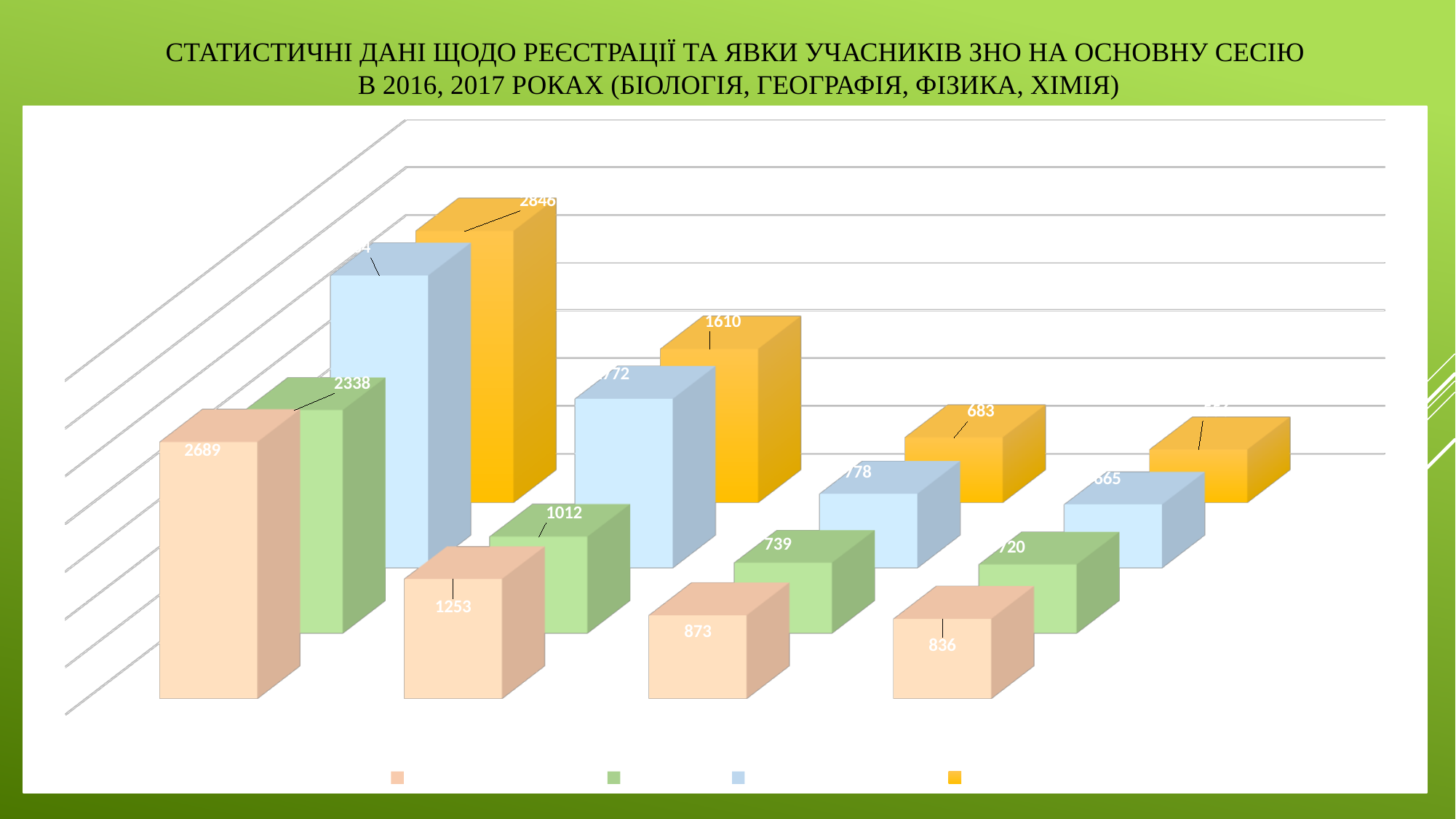
What is the difference between the peach bar values in the first and second groups from the left (2689 and 1253)? 1436 What kind of chart is shown on the slide? bar chart Which group has the highest value for the peach (front) series? the first group from the left Do the values of the peach (front) series rise or fall from left to right across the groups? fall What is the value of the yellow bar in the first group from the left? 2846 What is the value of the yellow bar in the second group from the left? 1610 How many series does the legend list? 4 What is the value of the green bar in the first group from the left? 2338 What is the value of the peach (front) bar in the fourth group from the left? 836 How many groups of bars are plotted along the x axis? 4 Which is larger in the third group from the left: the peach bar (873) or the green bar (739)? the peach bar (873) What is the value of the peach (front) bar in the first group from the left? 2689